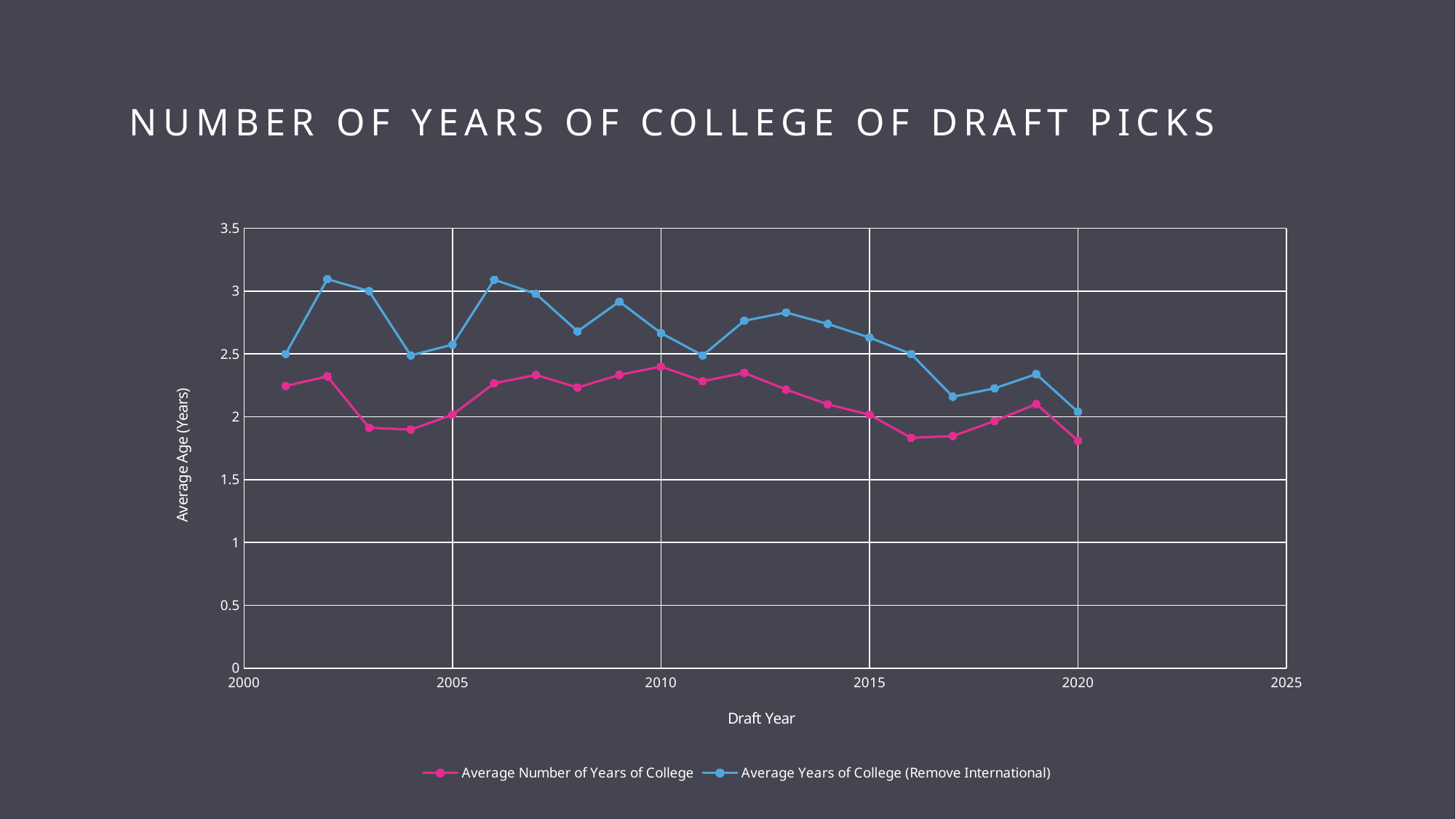
What is the label on the vertical axis? Average Age (Years) What is the title of the chart? Number of Years of College of Draft Picks Is the value for Average Years of College (Remove International) in 2002 greater or less than 3? greater In 2005, which series has the higher value: Average Number of Years of College or Average Years of College (Remove International)? Average Years of College (Remove International) Is the value for Average Number of Years of College in 2010 greater or less than 2.5? less How many data points are plotted for the Average Number of Years of College series? 20 What kind of chart is shown on the slide? Line chart For the Average Years of College (Remove International) series, which year has the higher value: 2008 or 2009? 2009 How many series does the legend list? 2 Is the value for Average Years of College (Remove International) in 2017 greater or less than 2? greater Does the Average Years of College (Remove International) series rise or fall from 2013 to 2017? fall